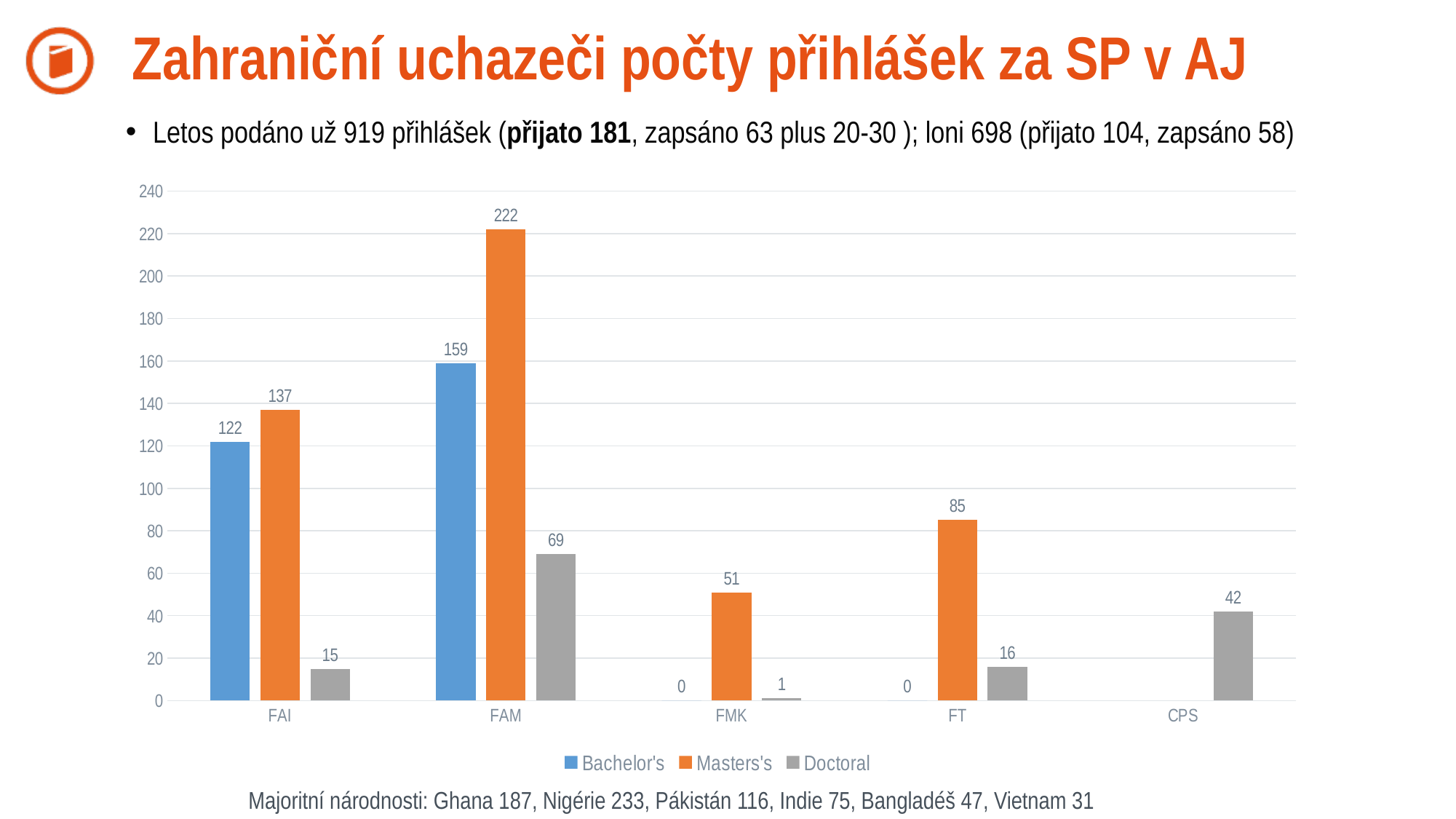
What is the Doctoral value for CPS? 42 How many series does the legend list? 3 Is the Doctoral value for FAM greater or less than 60? greater Which category has the highest Masters's value? FAM Which is larger, the Masters's value for FT or the Masters's value for FMK? FT Which colour represents the Doctoral series in the chart? grey What kind of chart is shown on the slide? bar chart What is the difference between the Masters's and Bachelor's values for FAM? 63 Which category has the lowest Doctoral value? FMK How many categories are shown on the x axis? 5 What is the Masters's value for FAM? 222 What is the Bachelor's value for FAI? 122